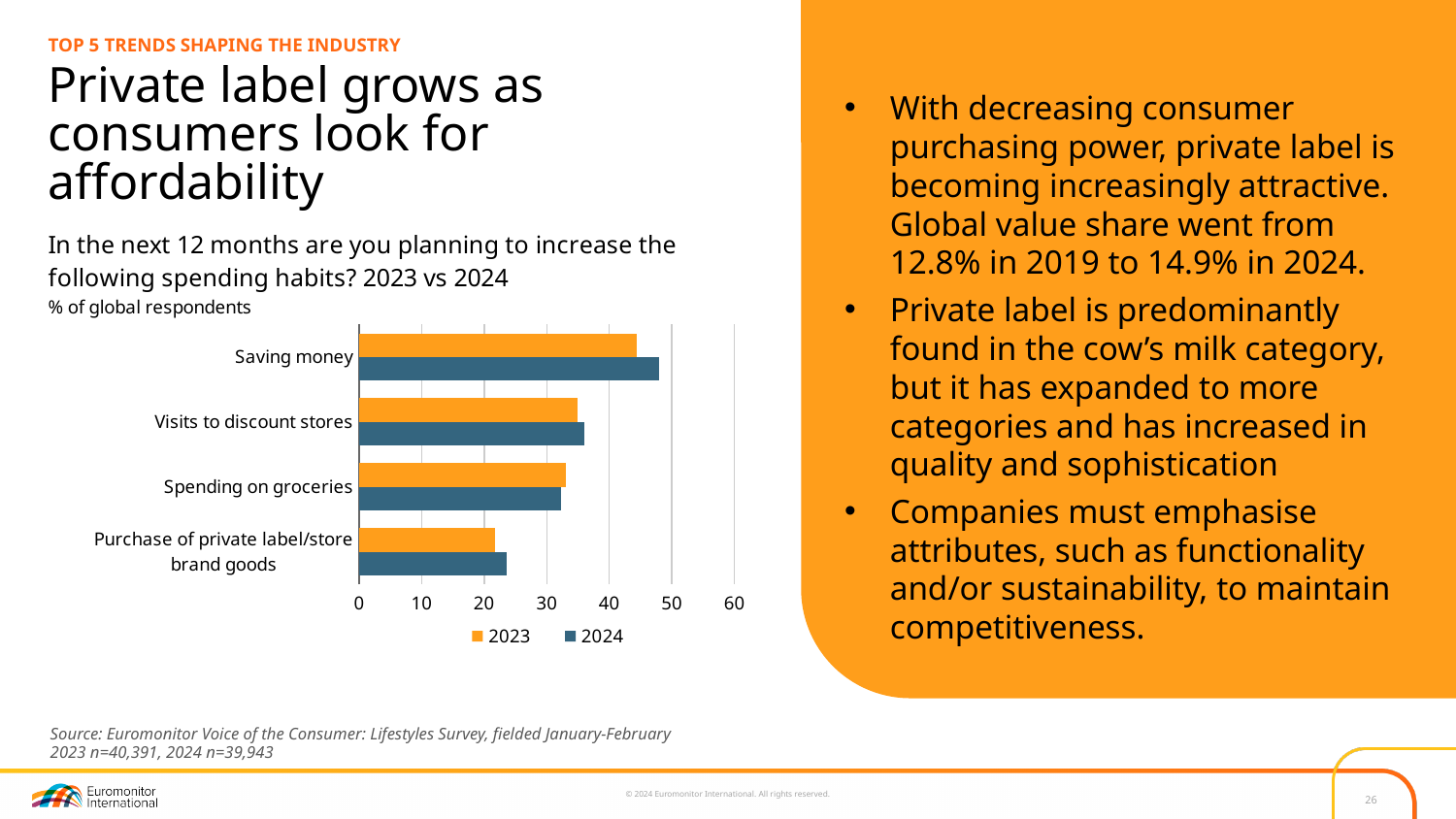
How many series does the chart legend list? 2 Which colour represents the 2023 series in the chart? Orange Is the 2023 value for Purchase of private label/store brand goods greater or less than 30? less How many spending habit categories are shown in the chart? 4 Which category has the highest value for 2024? Saving money Which category has the lowest value for 2023? Purchase of private label/store brand goods Is the 2023 value for Spending on groceries greater or less than 40? less What unit is the chart measured in, according to the subtitle above it? % of global respondents For Saving money, which year has the larger value, 2023 or 2024? 2024 What kind of chart is shown on the slide? Bar chart Is the 2024 value for Saving money greater or less than 40? greater